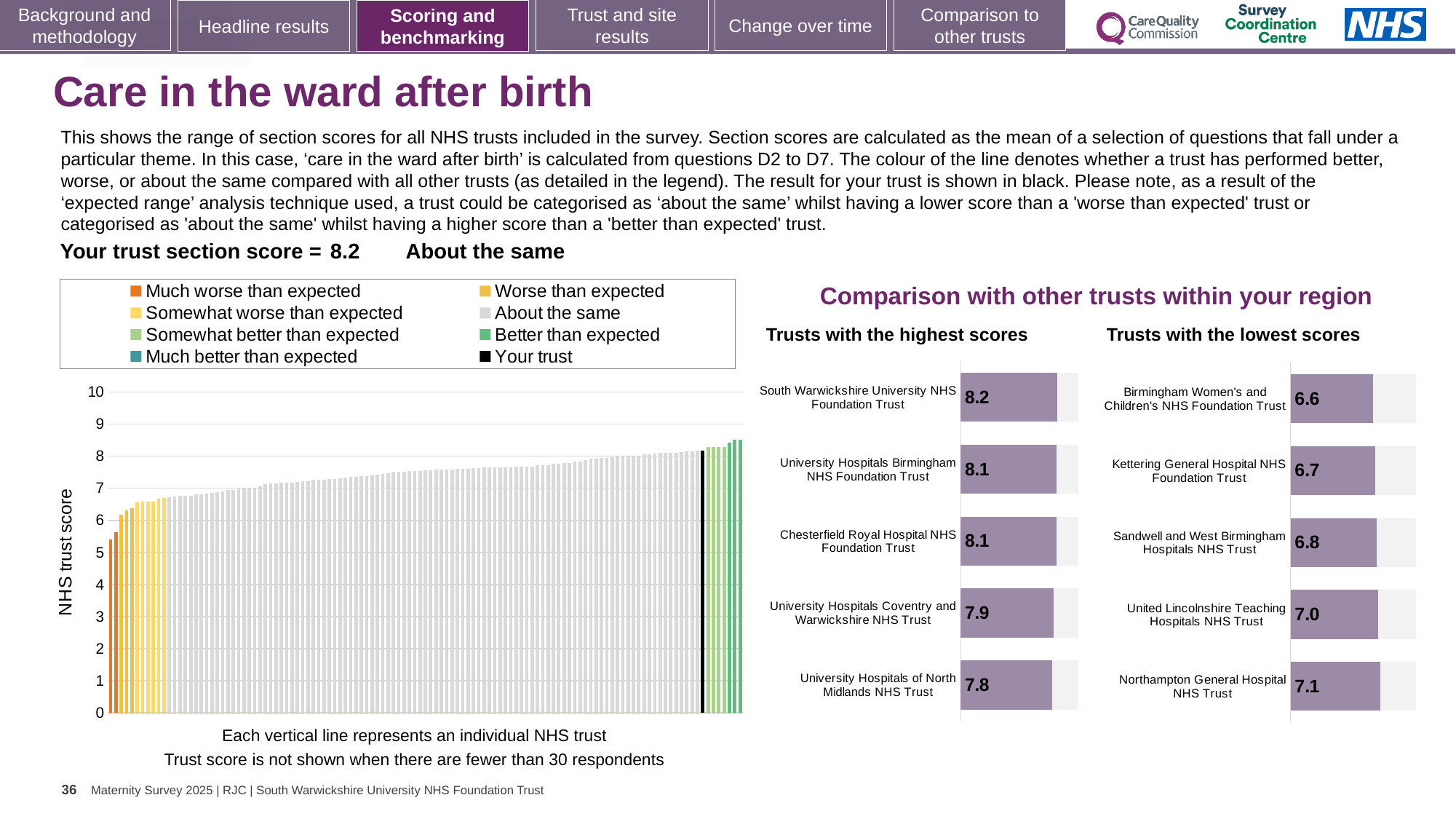
In the 'Trusts with the lowest scores' chart, which trust has the lowest score? Birmingham Women's and Children's NHS Foundation Trust In the 'Trusts with the highest scores' chart, which trust has the highest score? South Warwickshire University NHS Foundation Trust In the 'Trusts with the highest scores' chart, what is the difference between the scores of South Warwickshire University NHS Foundation Trust and University Hospitals of North Midlands NHS Trust? 0.4 In the 'Trusts with the lowest scores' chart, which has the larger score: Kettering General Hospital NHS Foundation Trust or Northampton General Hospital NHS Trust? Northampton General Hospital NHS Trust In the 'Trusts with the lowest scores' chart, what is the difference between the scores of Northampton General Hospital NHS Trust and Birmingham Women's and Children's NHS Foundation Trust? 0.5 In the 'Trusts with the lowest scores' chart, what is the score for United Lincolnshire Teaching Hospitals NHS Trust? 7.0 In the large chart on the left, do the trust scores rise or fall from left to right along the x axis? rise In the 'Trusts with the lowest scores' chart, what is the score for Birmingham Women's and Children's NHS Foundation Trust? 6.6 In the 'Trusts with the highest scores' chart, what is the score for South Warwickshire University NHS Foundation Trust? 8.2 How many trusts are shown in the 'Trusts with the highest scores' chart? 5 How many entries does the legend of the large chart on the left list? 8 In the 'Trusts with the highest scores' chart, what is the score for University Hospitals of North Midlands NHS Trust? 7.8